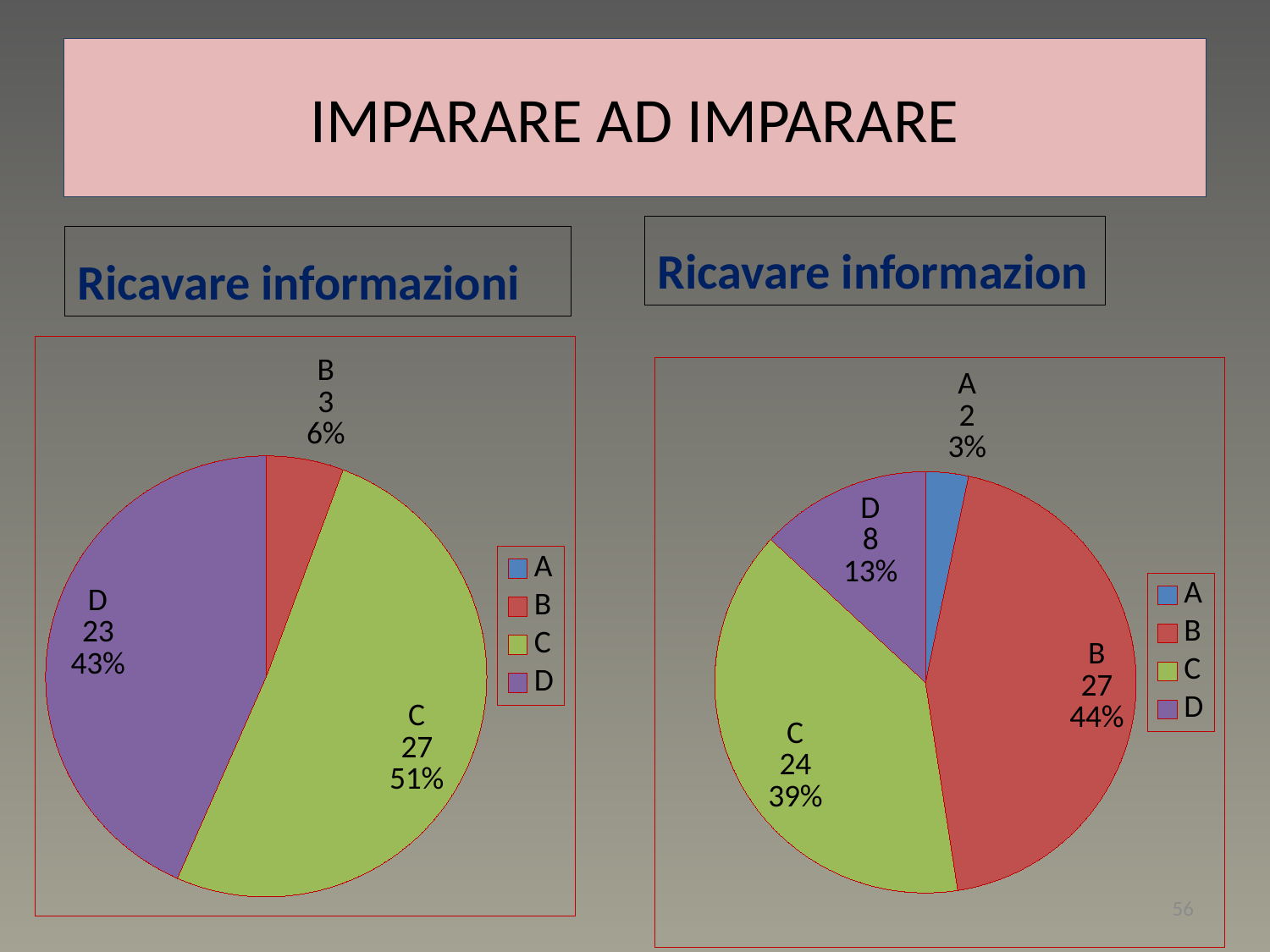
In the right pie chart, which category has the smallest slice? A What kind of chart is shown on the left side of the slide? Pie chart How many entries does the legend of the right pie chart list? 4 In the right pie chart, which is larger, the value for D or the value for A? D In the left pie chart, what share of the pie does category D represent? 43% In the left pie chart, which labelled category has the smallest slice? B In the right pie chart, which category has the largest slice? B In the right pie chart, what is the value for category B? 27 In the right pie chart, what share of the pie does category C represent? 39% In the left pie chart, what is the difference between the values for C and D? 4 In the left pie chart, what is the value for category C? 27 In the left pie chart, which category has the largest slice? C